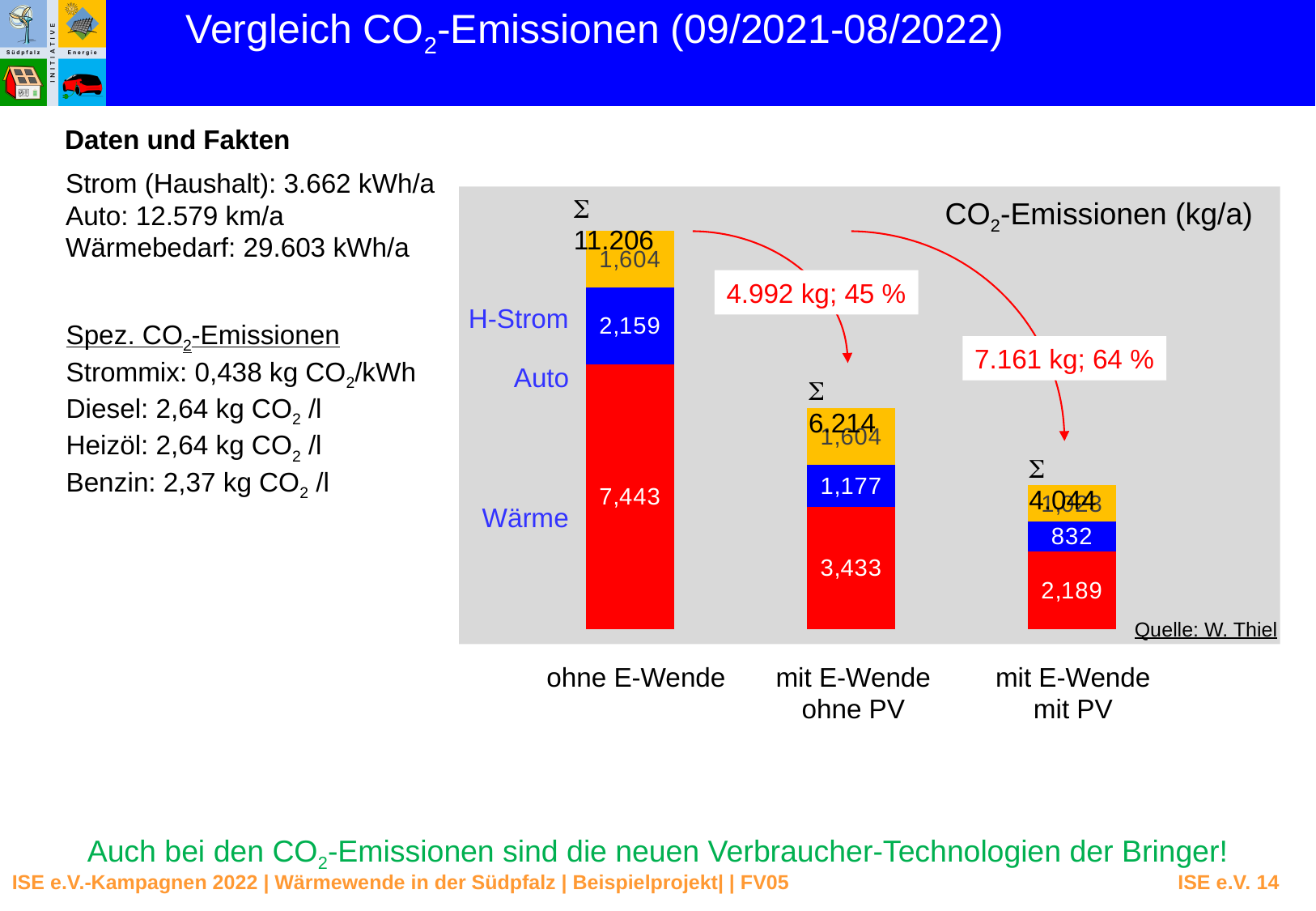
Do the total emissions rise or fall from left to right across the three bars? Fall What is the total (Σ) of the 'ohne E-Wende' bar? 11.206 What is the Wärme value for the 'ohne E-Wende' bar? 7,443 What is the Wärme value for the 'mit E-Wende mit PV' bar? 2,189 What is the difference between the Wärme value for 'ohne E-Wende' and the Wärme value for 'mit E-Wende ohne PV'? 4,010 How many scenarios (categories) are shown on the x axis of the chart? 3 What is the Auto value for the 'mit E-Wende ohne PV' bar? 1,177 How many series are stacked in each bar of the chart? 3 Which scenario has the highest total CO2 emissions? ohne E-Wende What is the total (Σ) of the 'mit E-Wende mit PV' bar? 4.044 What is the Auto value for the 'mit E-Wende mit PV' bar? 832 What kind of chart is shown on the slide? Stacked bar chart